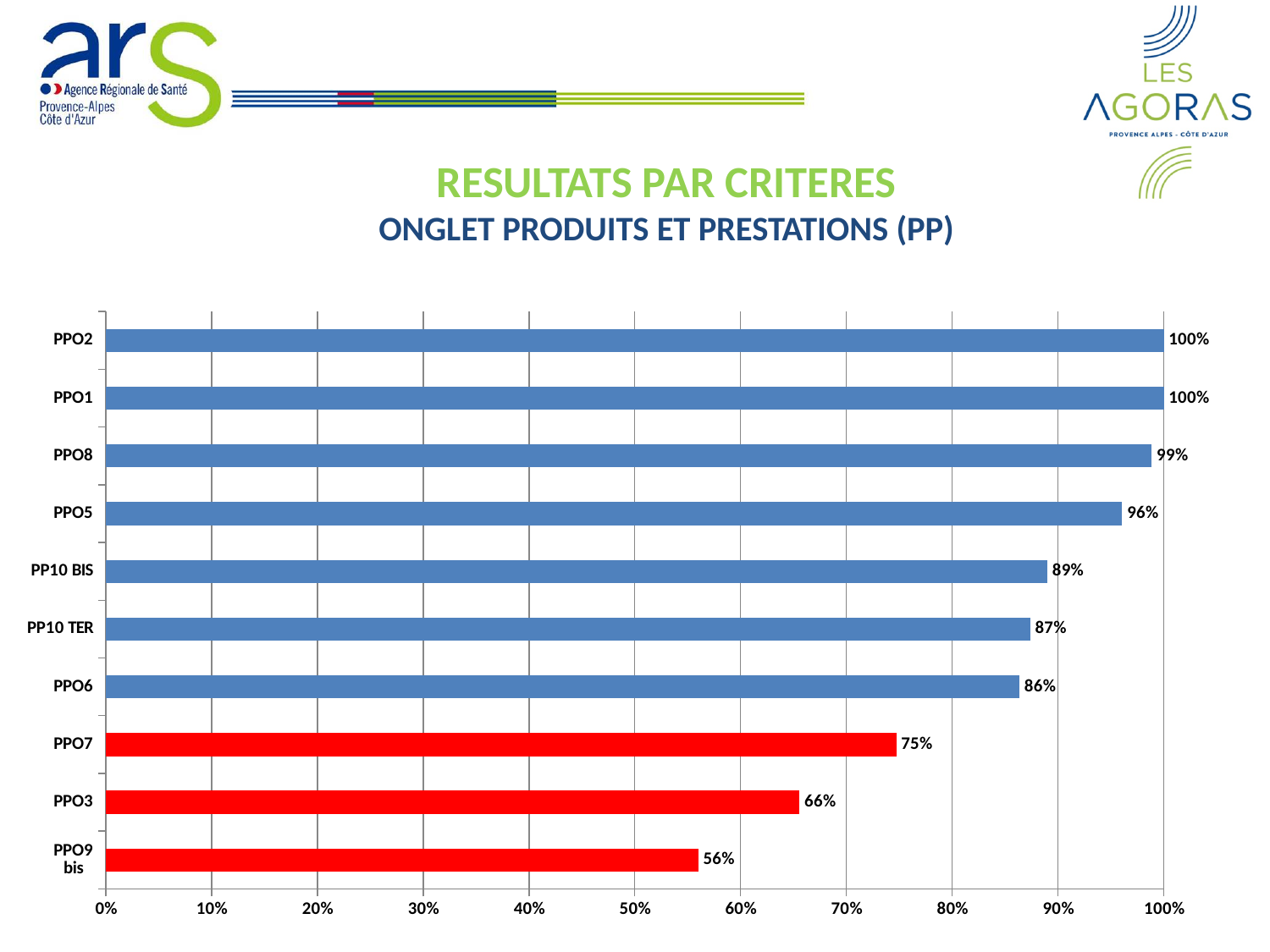
What is the value for PP10 TER? 87% How many categories are shown in the chart? 10 What is the value for PPO3? 66% What kind of chart is shown on the slide? bar chart Which is larger, the value for PPO7 or the value for PPO3? PPO7 Is the value for PPO9 bis greater or less than 60%? less What is the value for PPO8? 99% Which category has the lowest value? PPO9 bis What is the difference between the values for PPO5 and PPO7? 21% How many bars are coloured red? 3 Which categories share the highest value of 100%? PPO2 and PPO1 What is the difference between the values for PP10 BIS and PPO6? 3%